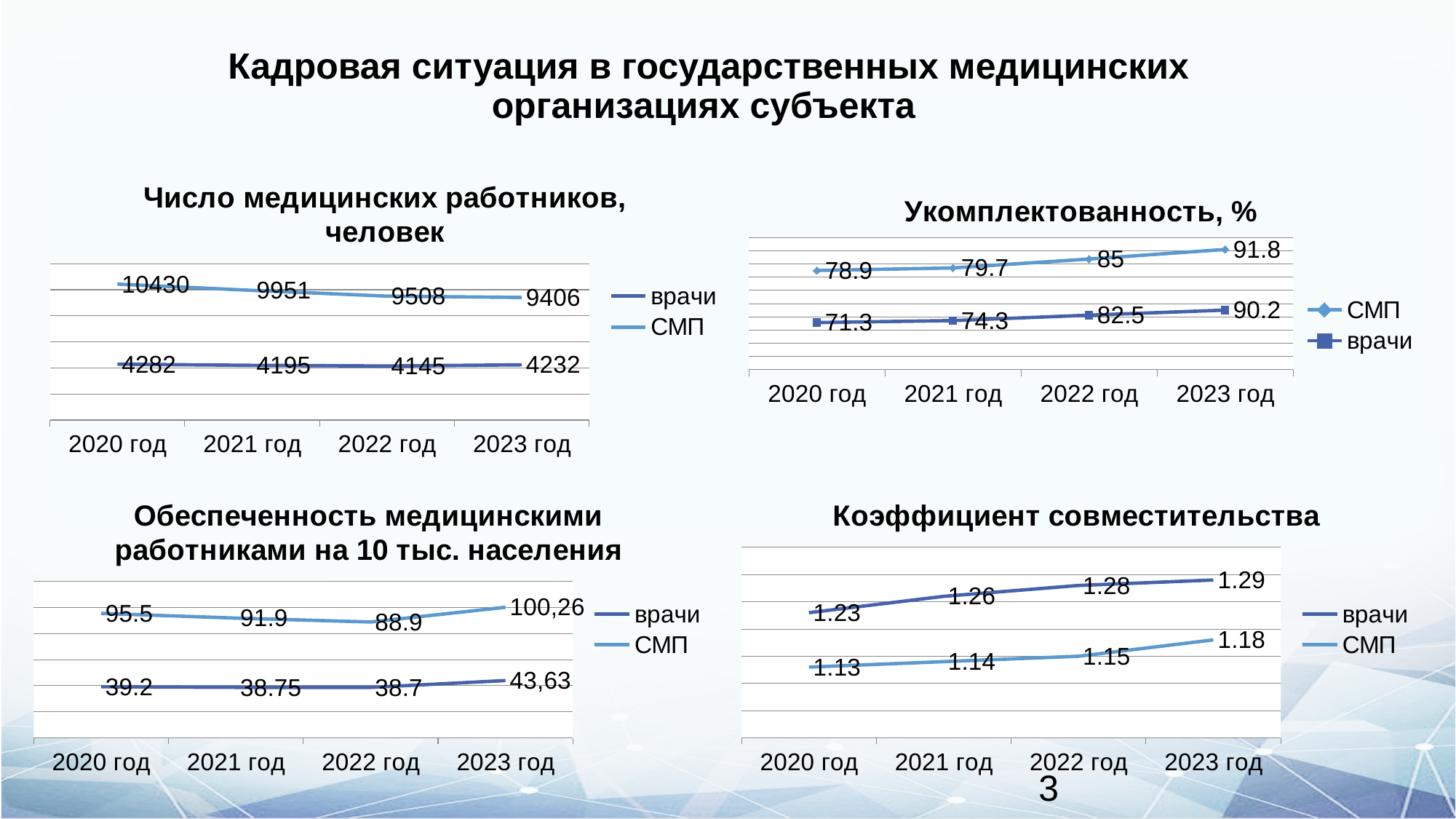
How many series does the legend of the chart 'Коэффициент совместительства' list? 2 In the chart 'Коэффициент совместительства', what is the difference between the врачи and СМП values in 2023 год? 0.11 In the chart 'Укомплектованность, %', what is the value for врачи in 2022 год? 82.5 In the chart 'Укомплектованность, %', does the врачи series rise or fall from 2020 год to 2023 год? rise In the chart 'Число медицинских работников, человек', what is the value for врачи in 2023 год? 4232 In the chart 'Укомплектованность, %', in which year is the СМП value highest? 2023 год In the chart 'Число медицинских работников, человек', what is the value for СМП in 2020 год? 10430 In the chart 'Обеспеченность медицинскими работниками на 10 тыс. населения', what is the value for СМП in 2023 год? 100,26 In the chart 'Число медицинских работников, человек', in which year is the СМП value lowest? 2023 год In the chart 'Обеспеченность медицинскими работниками на 10 тыс. населения', which is larger in 2021 год: врачи or СМП? СМП In the chart 'Коэффициент совместительства', what is the value for СМП in 2021 год? 1.14 In the chart 'Число медицинских работников, человек', what is the difference between the СМП values for 2020 год and 2021 год? 479